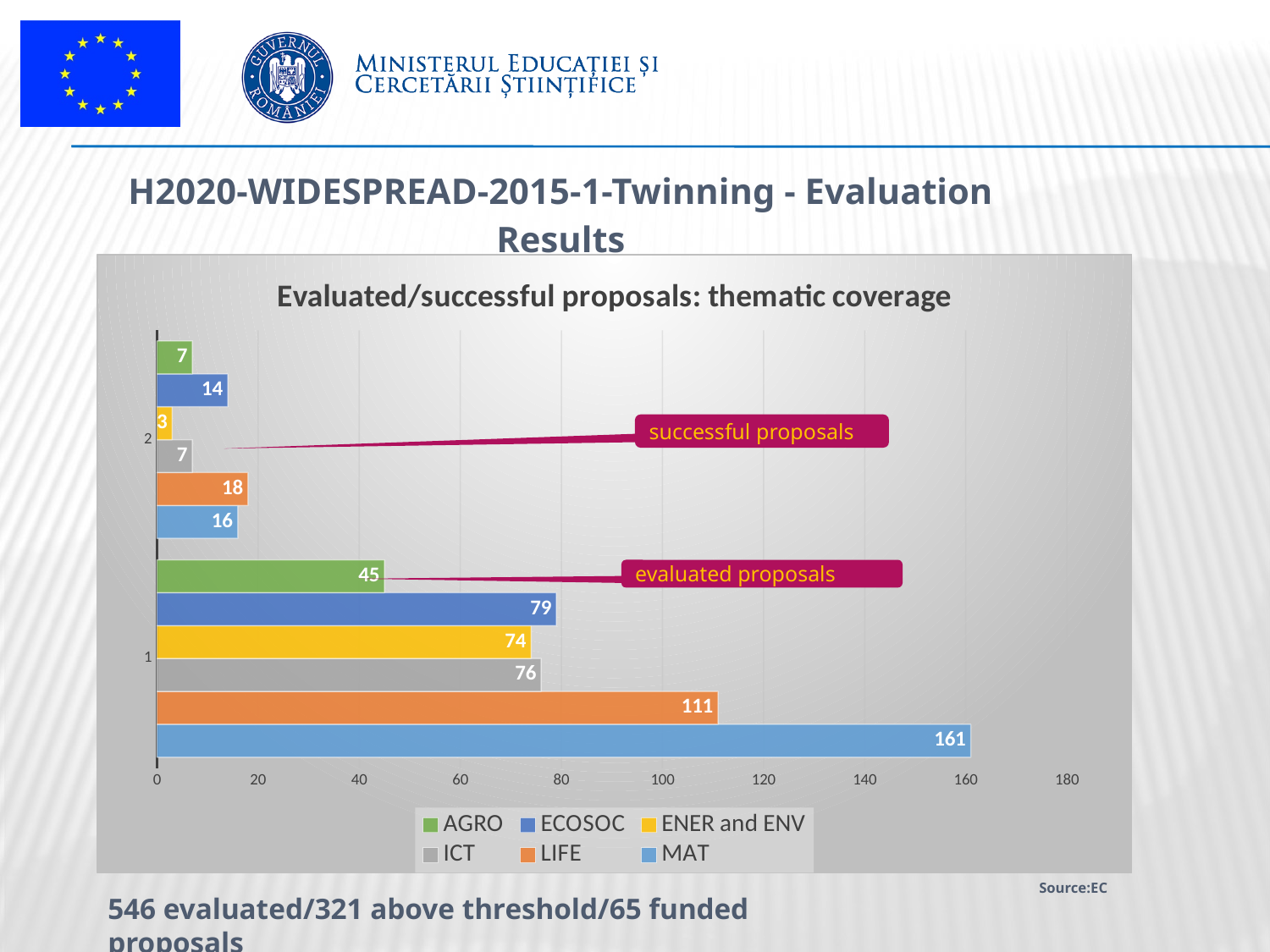
Which had more successful proposals, LIFE or MAT? LIFE How many successful proposals were there for LIFE? 18 How many evaluated proposals were there for MAT? 161 Which thematic area had the most evaluated proposals? MAT What type of chart is shown on the slide? bar chart Which thematic area had the fewest successful proposals? ENER and ENV How many series does the legend list? 6 What is the difference between the evaluated proposals for LIFE and for AGRO? 66 Which colour represents ICT in the chart? grey What is the title of the chart? Evaluated/successful proposals: thematic coverage What is the difference between evaluated and successful proposals for ECOSOC? 65 How many evaluated proposals were there for ENER and ENV? 74